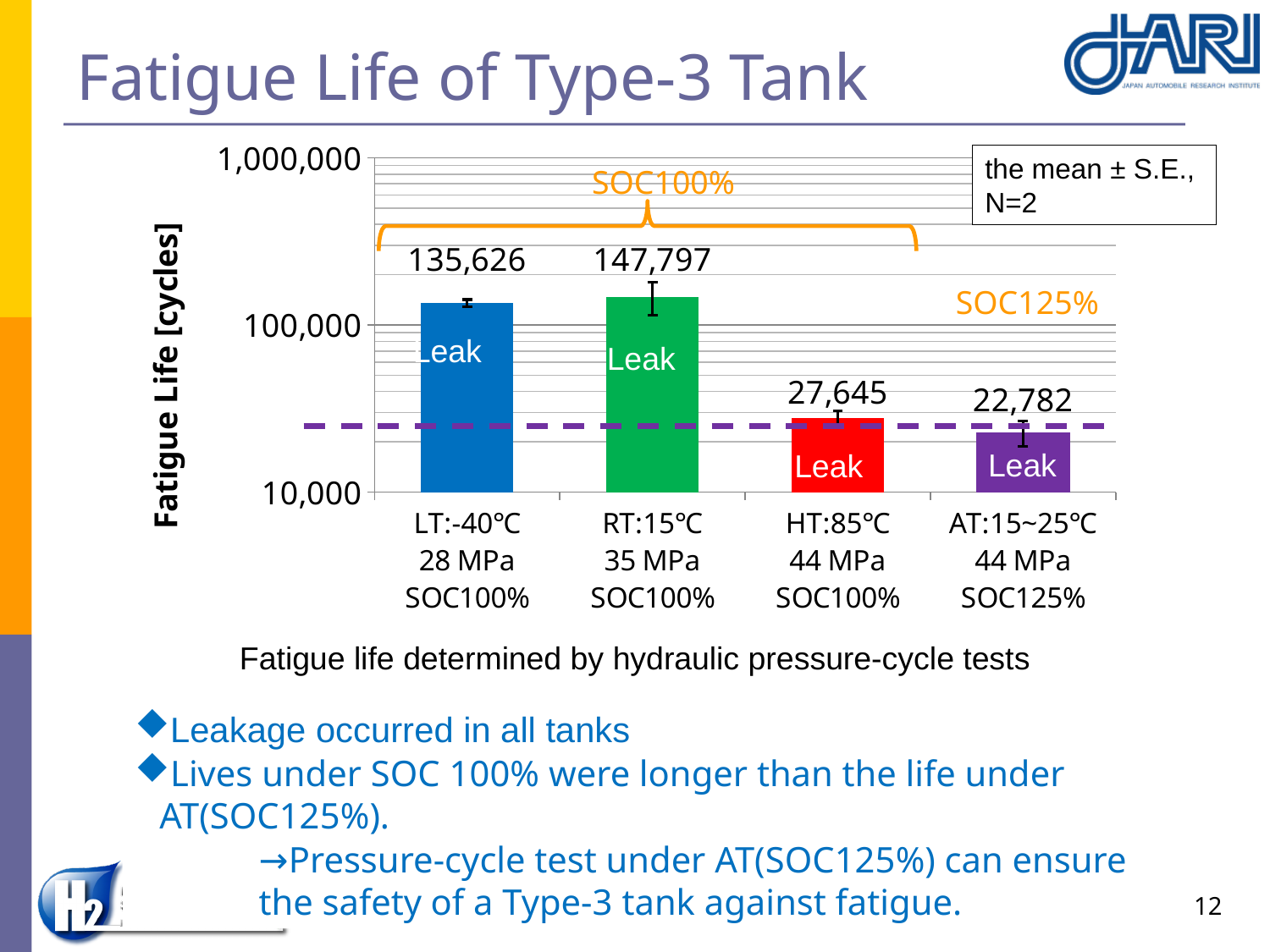
What is the difference in fatigue life between the RT:15℃ and LT:-40℃ conditions? 12,171 How many test conditions (bars) are shown in the chart? 4 Which has a larger fatigue life, the HT:85℃ condition or the AT:15~25℃ condition? HT:85℃ Is the fatigue life for the LT:-40℃ condition greater or less than 100,000 cycles? greater What is the difference in fatigue life between the HT:85℃ and AT:15~25℃ conditions? 4,863 Which test condition has the highest fatigue life? RT:15℃ What type of chart is used to show the fatigue life of the Type-3 tank? Bar chart What is the fatigue life value shown for the HT:85℃ condition? 27,645 What is the fatigue life value shown for the AT:15~25℃ (SOC125%) condition? 22,782 What is the fatigue life value shown for the LT:-40℃ condition? 135,626 Which test condition has the lowest fatigue life? AT:15~25℃ What is the fatigue life value shown for the RT:15℃ condition? 147,797